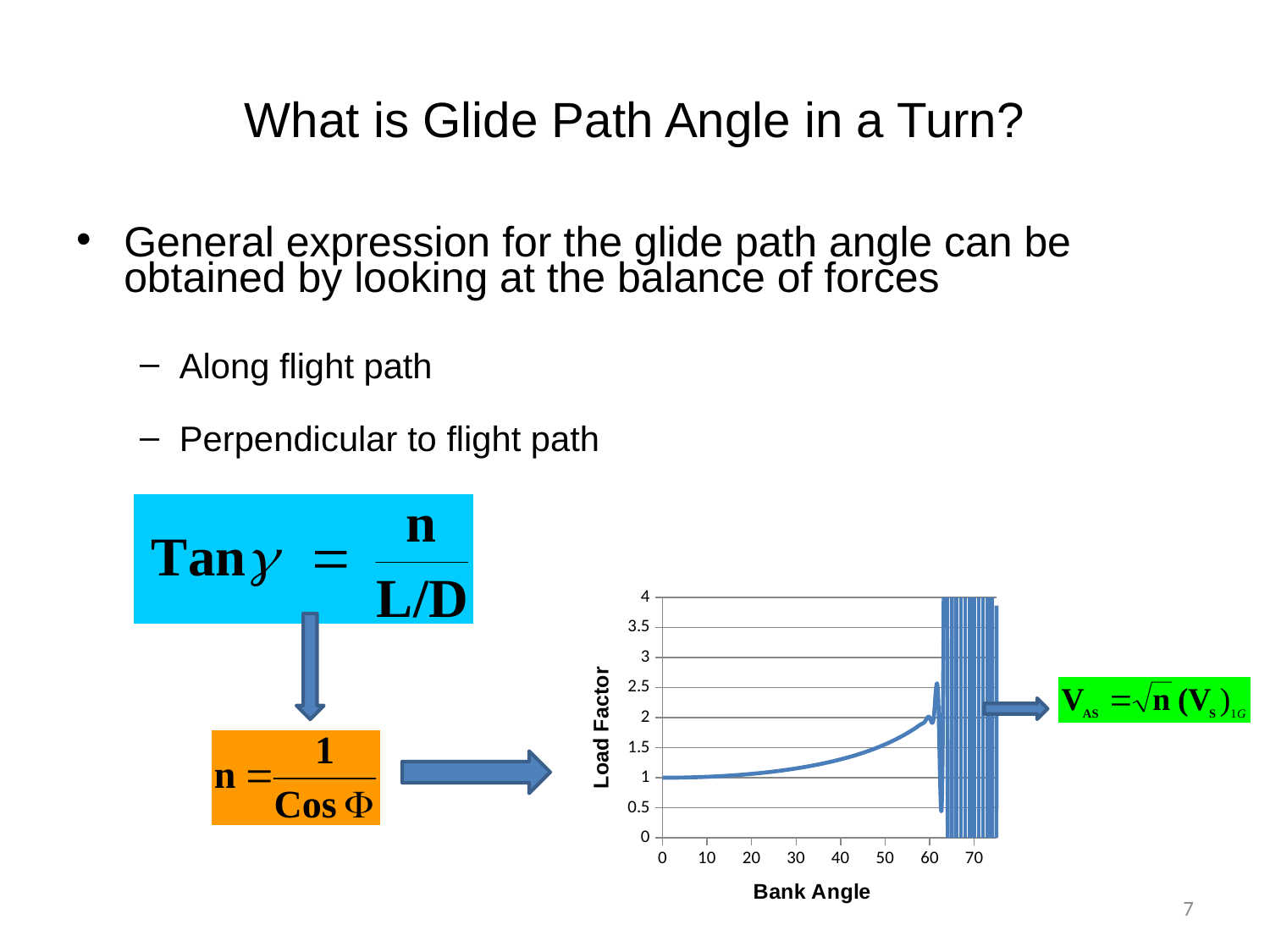
Does the load factor rise or fall as the bank angle increases from 0 to 60? rise What kind of chart is shown on the slide? line chart Which bank angle has the larger load factor, 20 or 50? 50 Is the load factor at a bank angle of 55 greater or less than 1? greater Is the load factor at a bank angle of 40 greater or less than 1.5? less What is the load factor at a bank angle of 0? 1 What is the maximum value shown on the Load Factor axis? 4 What is the title of the y axis of the chart? Load Factor Is the load factor at a bank angle of 30 greater or less than 1? greater What is the title of the x axis of the chart? Bank Angle